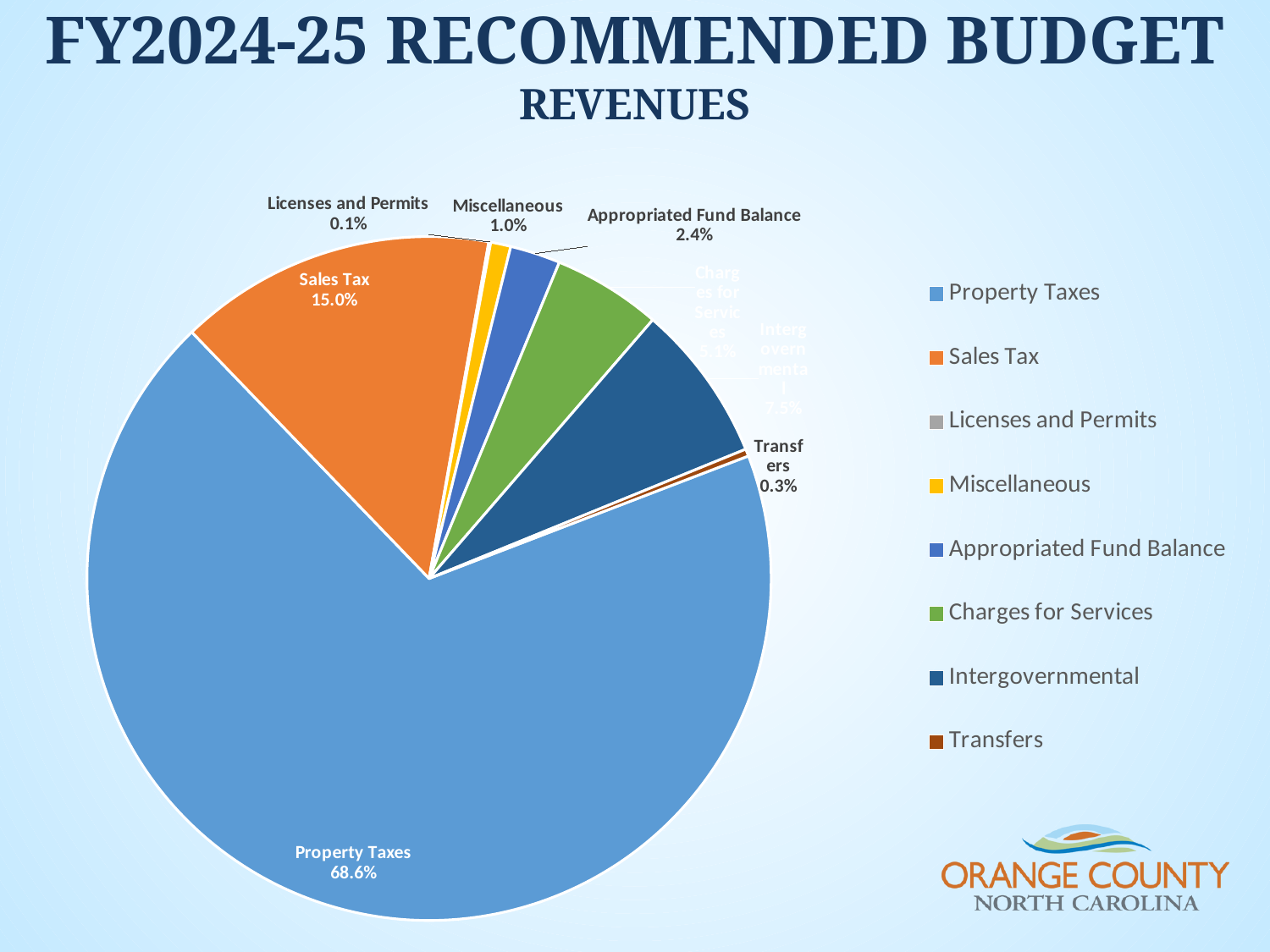
What percentage is shown for Transfers? 0.3% What percentage is shown for Miscellaneous revenues? 1.0% What type of chart is shown on the slide? Pie chart What share of revenues comes from Property Taxes? 68.6% Which revenue category has the largest share of the pie? Property Taxes What percentage of revenues is Sales Tax? 15.0% What percentage is shown for Licenses and Permits? 0.1% How many percentage points larger is the Property Taxes share than the Sales Tax share? 53.6 percentage points What percentage is shown for Appropriated Fund Balance? 2.4% How many revenue categories are listed in the legend? 8 Which revenue category has the smallest share of the pie? Licenses and Permits Which is larger, the Miscellaneous share or the Transfers share? Miscellaneous